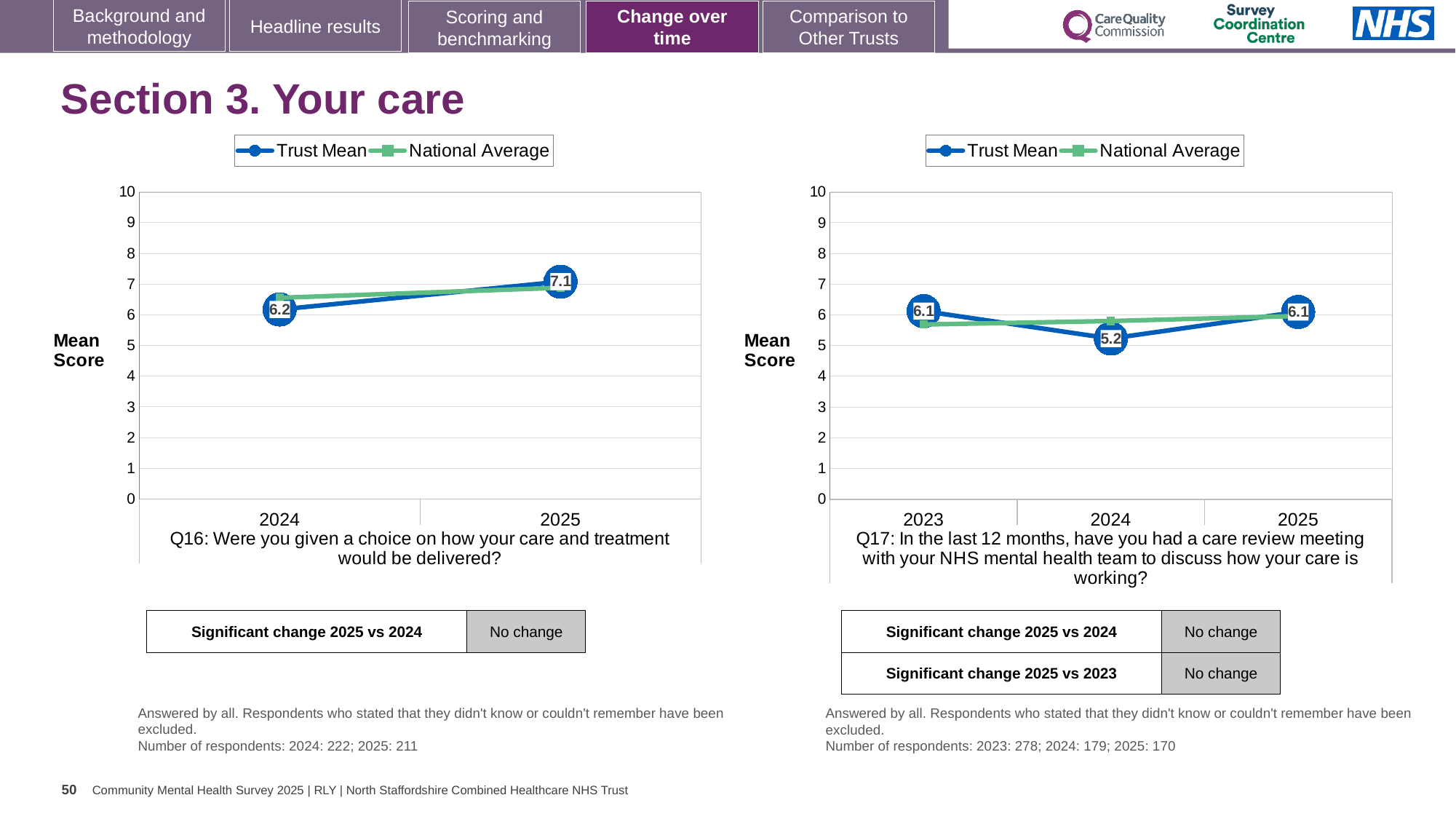
On the Q16 chart (left), is the National Average for 2024 greater or less than 6? greater On the Q16 chart (left), by how much did the Trust Mean change from 2024 to 2025? 0.9 On the Q17 chart (right), what is the Trust Mean score for 2024? 5.2 On the Q17 chart (right), which year has the lowest Trust Mean score? 2024 On the Q17 chart (right), how many years are shown on the x axis? 3 On the Q16 chart (left), what is the Trust Mean score for 2024? 6.2 What type of chart is the Q16 chart (left)? line chart On the Q17 chart (right), what is the Trust Mean score for 2023? 6.1 On the Q17 chart (right), what is the difference between the Trust Mean in 2023 and 2024? 0.9 On the Q16 chart (left), does the Trust Mean rise or fall from 2024 to 2025? rise On the Q17 chart (right), how many series does the legend list? 2 On the Q16 chart (left), what is the Trust Mean score for 2025? 7.1